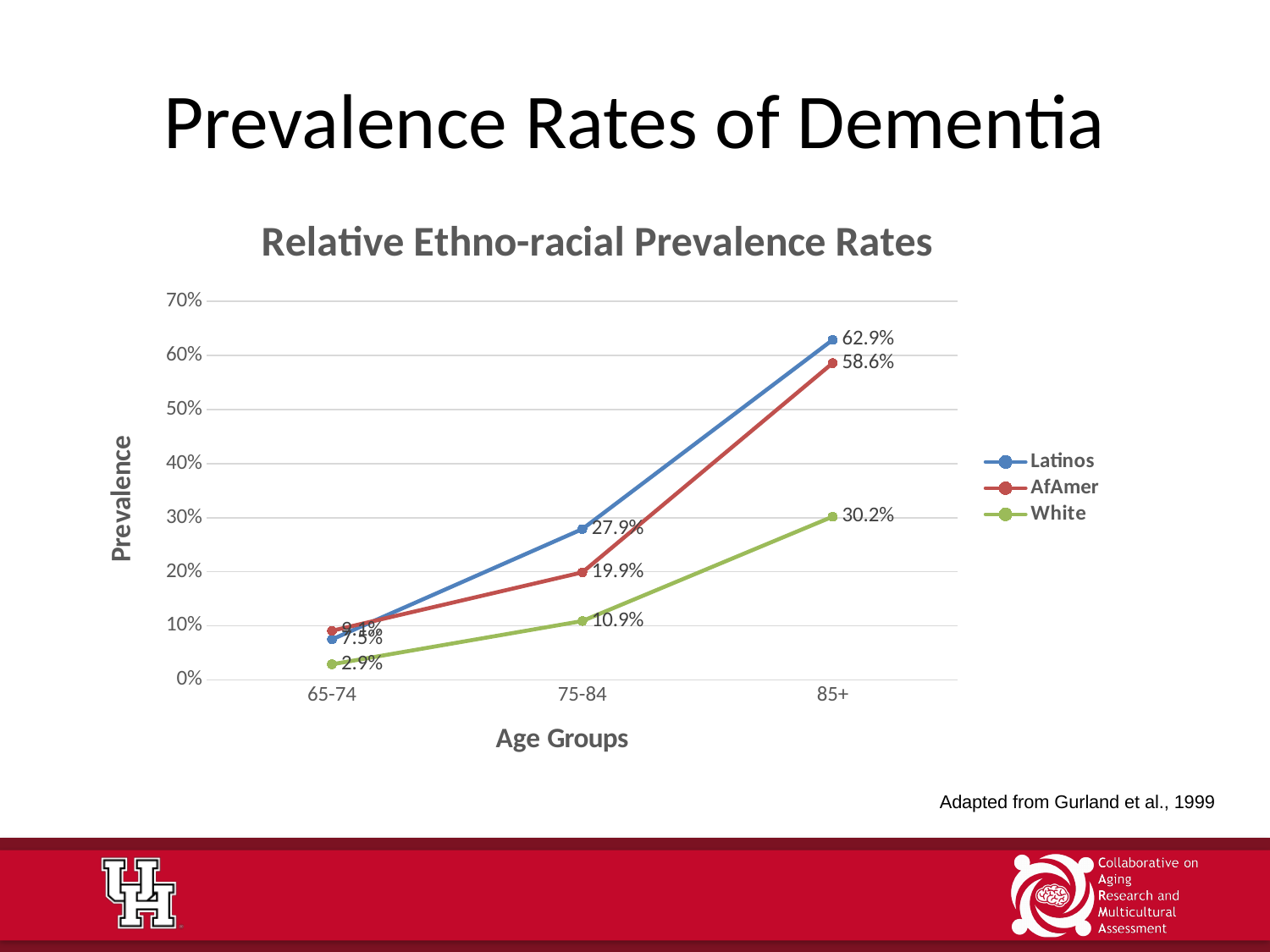
What is the difference between the Latinos and AfAmer prevalence rates in the 85+ age group? 4.3 percentage points What is the prevalence rate for White in the 85+ age group? 30.2% Do the prevalence rates rise or fall as age group increases? Rise What is the prevalence rate for AfAmer in the 75-84 age group? 19.9% What is the prevalence rate for Latinos in the 85+ age group? 62.9% How many series does the legend list? 3 What is the prevalence rate for White in the 65-74 age group? 2.9% What kind of chart is shown on the slide? Line chart Which group has the highest prevalence rate in the 85+ age group? Latinos What is the title of the chart? Relative Ethno-racial Prevalence Rates In the 75-84 age group, which is larger: the Latinos rate or the AfAmer rate? Latinos How many age groups are shown on the x axis? 3